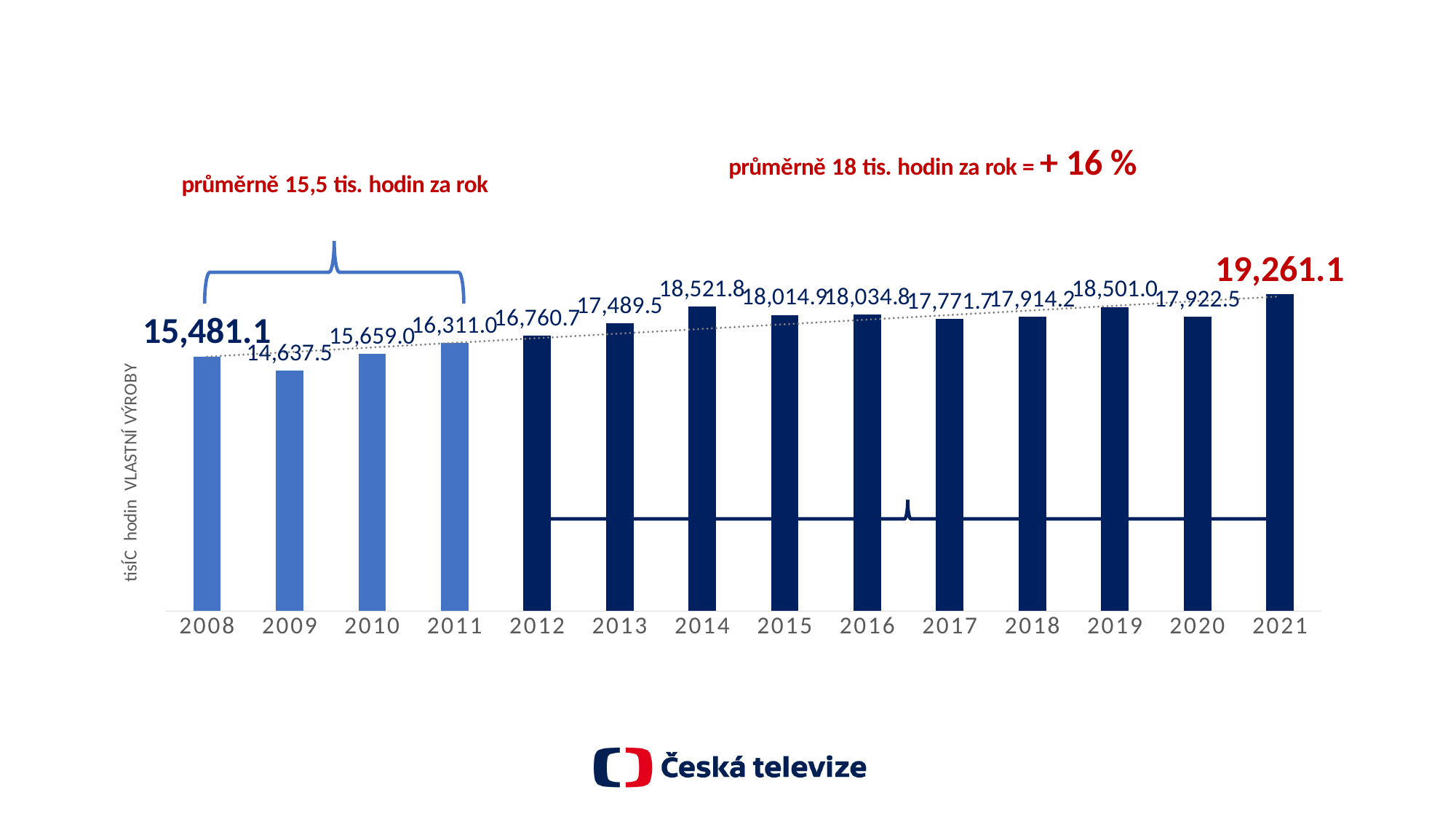
What is the difference between the values for 2021 and 2008? 3,780.0 What is the value for 2014? 18,521.8 What is the label on the vertical axis? tisíc hodin VLASTNÍ VÝROBY What is the difference between the values for 2014 and 2013? 1,032.3 What is the value for 2021? 19,261.1 What is the value for 2008? 15,481.1 What kind of chart is shown on the slide? Bar chart Which year has the lowest value? 2009 What is the value for 2017? 17,771.7 Which is larger, the value for 2019 or the value for 2020? 2019 How many years are shown on the x axis? 14 Which year has the highest value? 2021